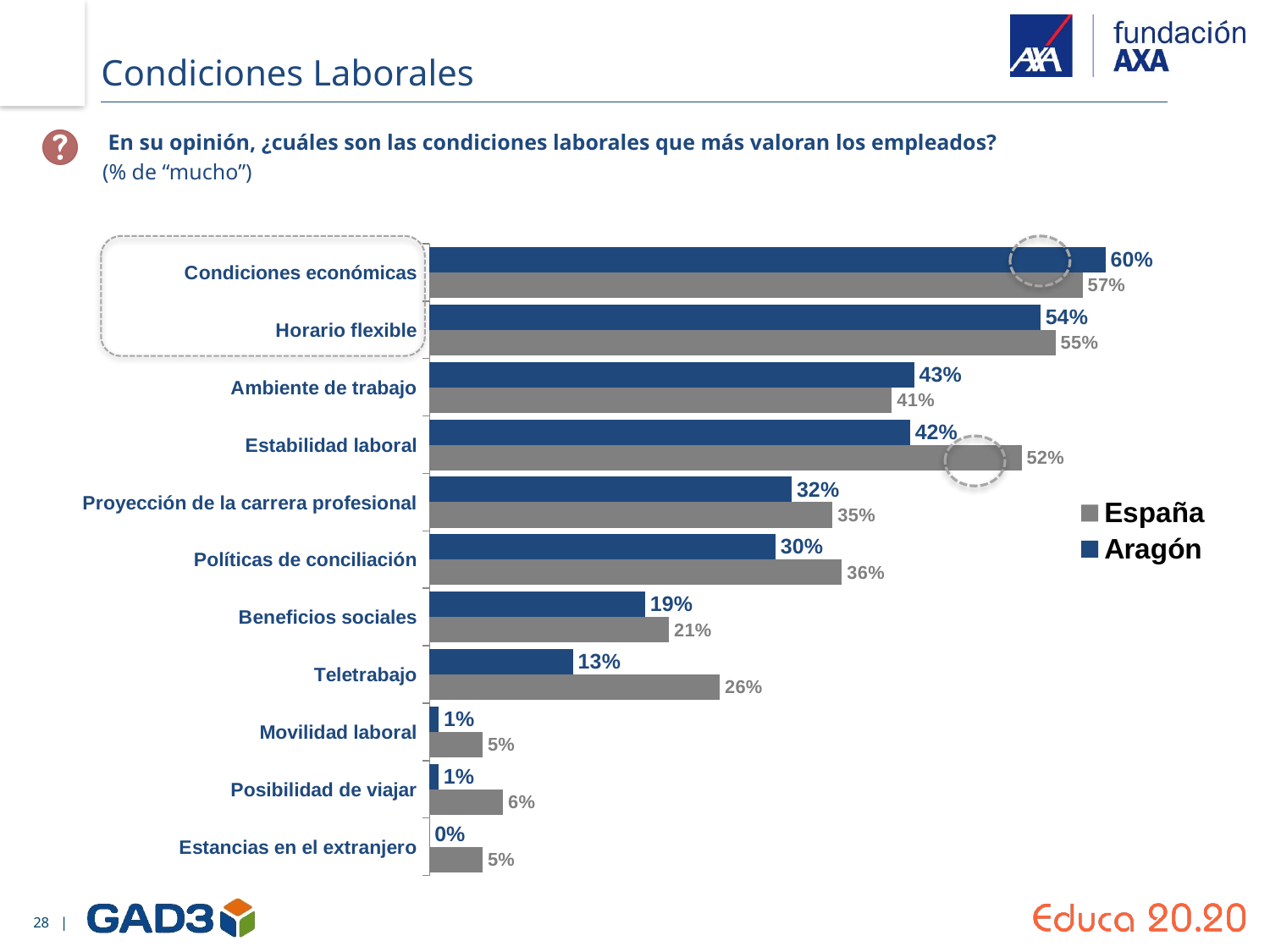
What is the value for España for Teletrabajo? 26% Which is larger for Políticas de conciliación, the España value or the Aragón value? España What kind of chart is shown on the slide? Bar chart Which colour represents Aragón in the chart? Blue What is the value for España for Estabilidad laboral? 52% What is the value for Aragón for Condiciones económicas? 60% How many series does the legend list? 2 Which category has the highest value for Aragón? Condiciones económicas What is the difference between the España and Aragón values for Teletrabajo? 13% What is the difference between the España and Aragón values for Estabilidad laboral? 10% How many categories are shown in the chart? 11 Which category has the lowest value for Aragón? Estancias en el extranjero